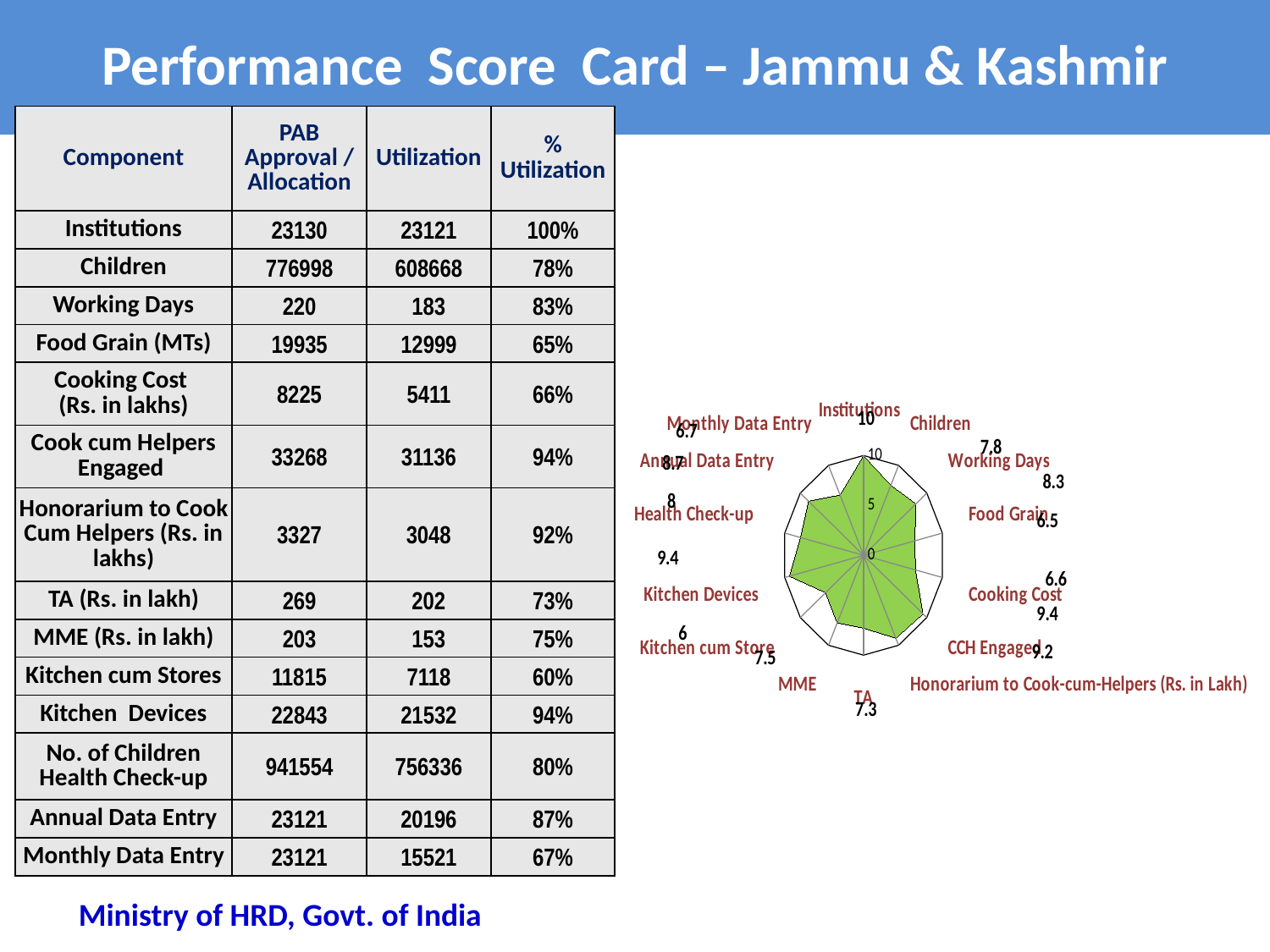
What is the value for Annual Data Entry on the radar chart? 8.7 What is the value for Working Days on the radar chart? 8.3 Is the value for Children on the radar chart greater or less than 5? greater What is the value for Honorarium to Cook-cum-Helpers (Rs. in Lakh) on the radar chart? 9.2 How many categories are plotted on the radar chart? 14 Which category has the highest value on the radar chart? Institutions What is the value for Institutions on the radar chart? 10 Which has a larger value on the radar chart, Working Days or Food Grain? Working Days What kind of chart is shown on the slide? Radar chart Which category has the lowest value on the radar chart? Kitchen cum Store What is the value for Food Grain on the radar chart? 6.5 What is the difference between the values for Institutions and Kitchen cum Store on the radar chart? 4